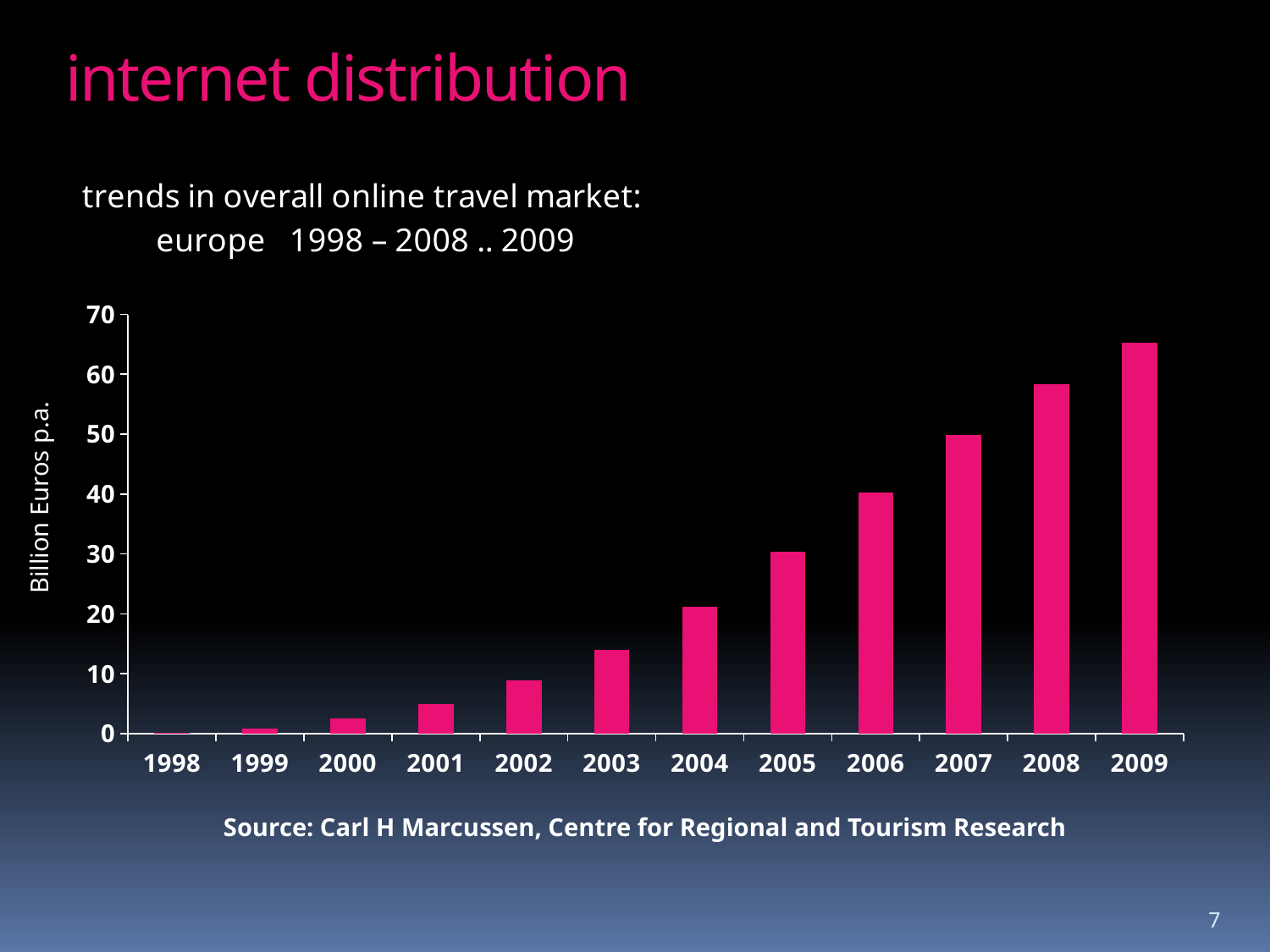
Is the value for 2006 greater or less than 30? greater Is the value for 2004 greater or less than 30? less Is the value for 2002 greater or less than 10? less Which year has the highest value in the chart? 2009 Which year has the lowest value in the chart? 1998 Which is larger, the value for 2007 or the value for 2004? 2007 What kind of chart is shown on the slide? bar chart How many years are plotted on the x axis of the chart? 12 What is the label on the y axis of the chart? Billion Euros p.a. Do the values rise or fall from 1998 to 2009? rise